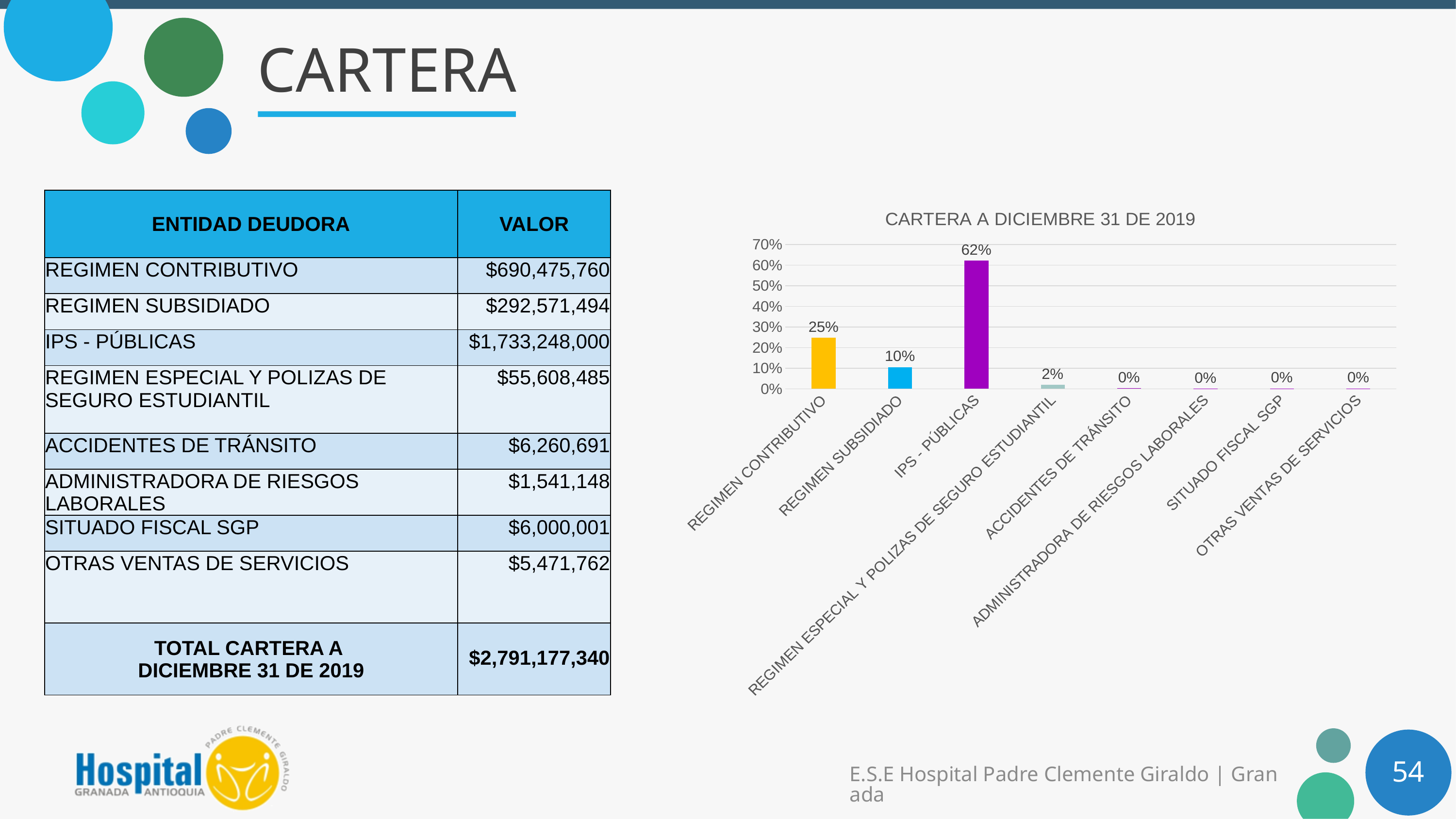
Which is larger, the value for REGIMEN CONTRIBUTIVO or the value for REGIMEN SUBSIDIADO? REGIMEN CONTRIBUTIVO Is the value for IPS - PÚBLICAS greater or less than 50%? greater What is the title of the chart? CARTERA A DICIEMBRE 31 DE 2019 What is the difference between the values for IPS - PÚBLICAS and REGIMEN CONTRIBUTIVO? 37% What is the value shown for SITUADO FISCAL SGP in the chart? 0% What kind of chart is shown on the slide? bar chart What is the value for REGIMEN CONTRIBUTIVO in the chart? 25% How many categories are shown on the x axis of the chart? 8 What is the value for IPS - PÚBLICAS in the chart? 62% Which category has the highest value in the chart? IPS - PÚBLICAS What is the value for REGIMEN ESPECIAL Y POLIZAS DE SEGURO ESTUDIANTIL in the chart? 2% What is the value for REGIMEN SUBSIDIADO in the chart? 10%